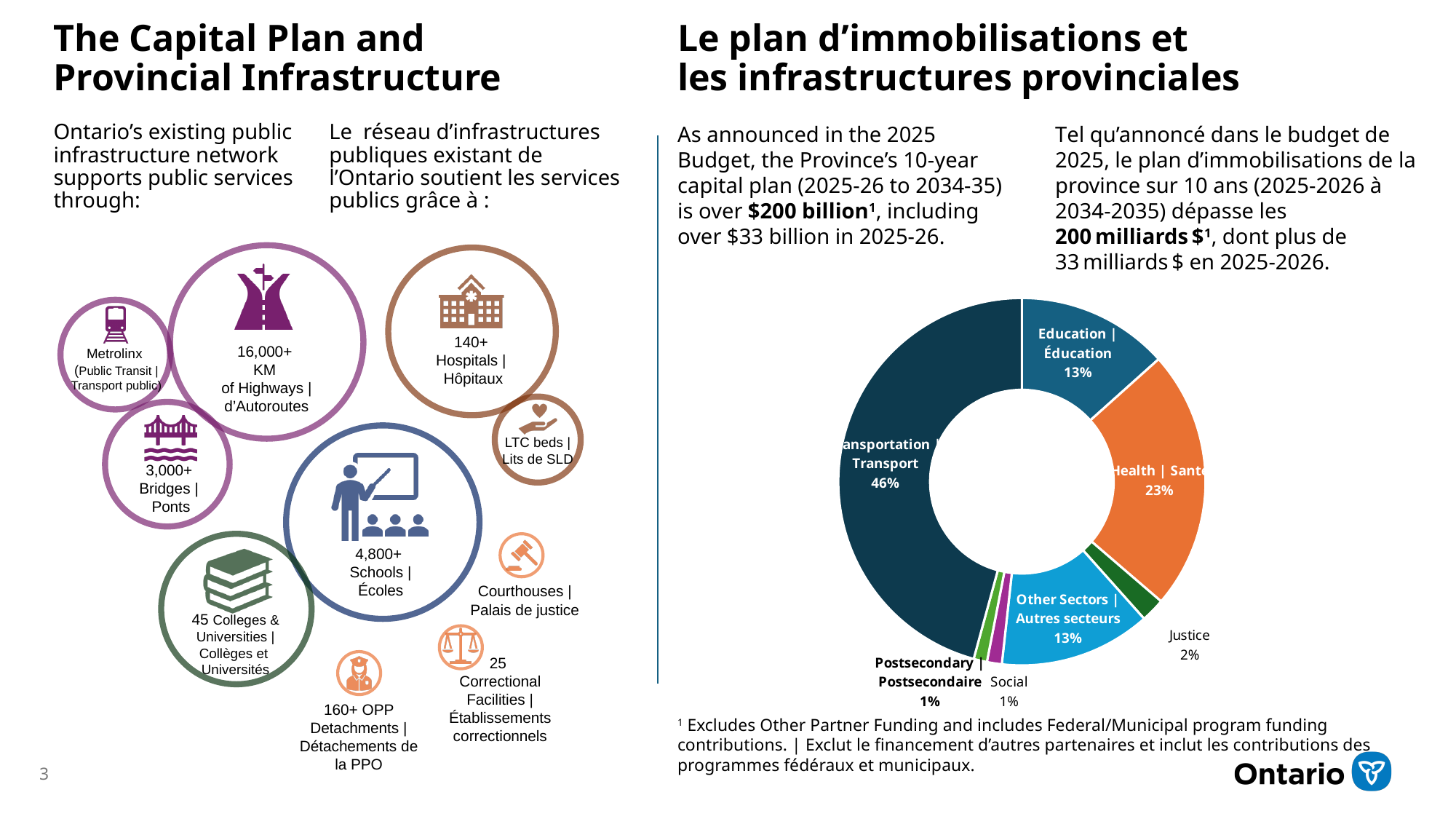
In the donut chart, what percentage is shown for Social? 1% In the donut chart, what percentage is shown for Education | Éducation? 13% In the donut chart, what percentage is shown for Other Sectors | Autres secteurs? 13% In the donut chart, which is larger: the share for Health | Santé or the share for Education | Éducation? Health | Santé In the donut chart, what share of the capital plan goes to Transportation | Transport? 46% In the donut chart, what percentage is shown for Health | Santé? 23% What kind of chart is shown on the right side of the slide? Donut (pie) chart In the donut chart, what percentage is shown for Justice? 2% How many sectors are shown in the donut chart? 7 In the donut chart, what is the difference in percentage points between Justice and Postsecondary? 1 In the donut chart, how many percentage points larger is the Transportation share than the Health share? 23 Which sector has the largest share in the donut chart? Transportation | Transport